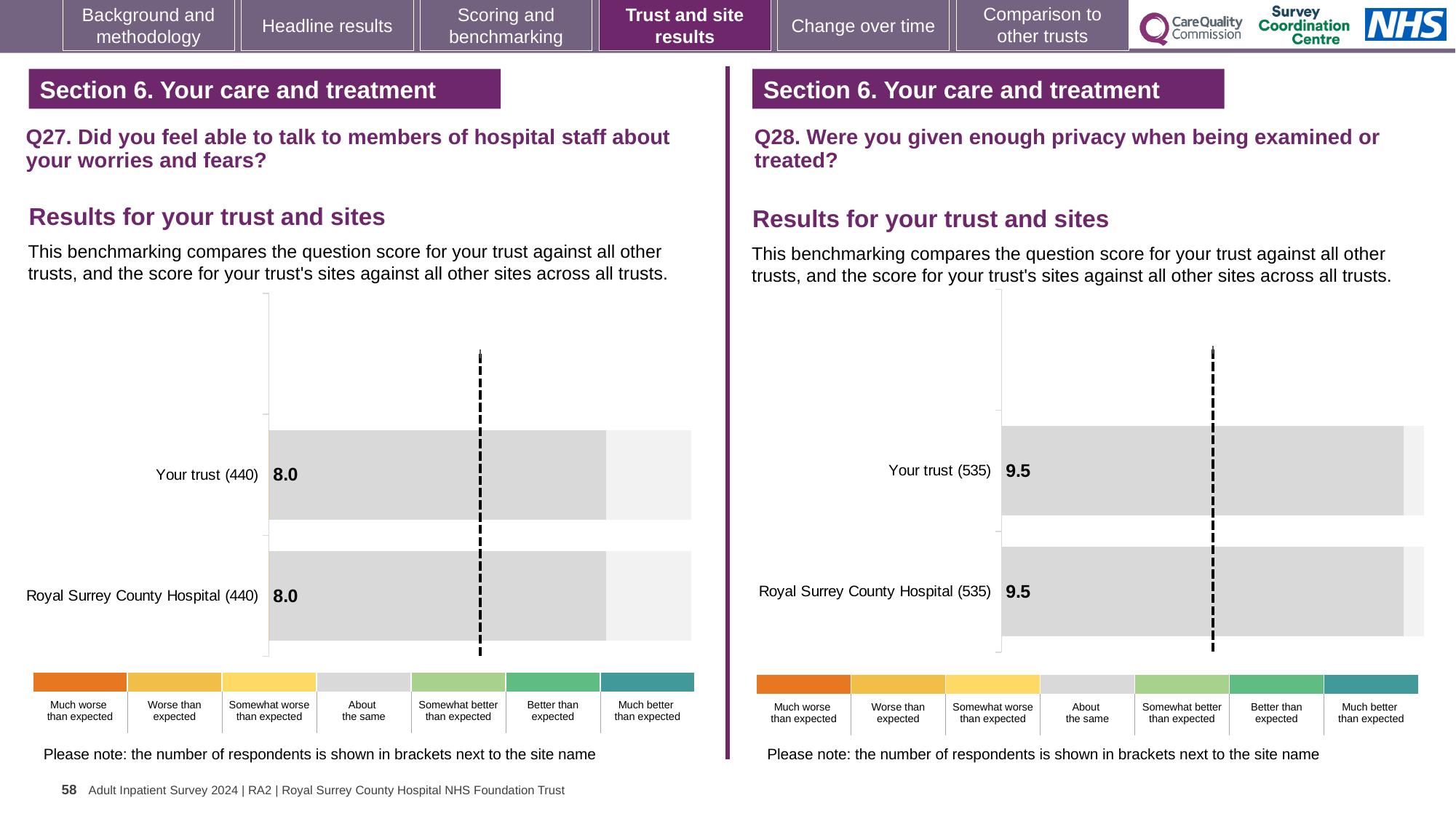
How many categories does the colour legend below the Q27 chart list? 7 How many respondents are shown in brackets for Your trust in the Q28 chart? 535 In the Q27 chart, what is the score for Your trust (440)? 8.0 What kind of chart is used for the Q27 results? Bar chart How many bars are plotted in the Q27 chart? 2 In the Q28 chart, what is the score for Royal Surrey County Hospital (535)? 9.5 Which legend category is shown in dark orange below the Q28 chart? Much worse than expected In the Q27 chart, what is the score for Royal Surrey County Hospital (440)? 8.0 In the Q28 chart, what is the difference between the score for Your trust and the score for Royal Surrey County Hospital? 0.0 In the Q28 chart, what is the score for Your trust (535)? 9.5 In the Q27 chart, what is the difference between the score for Your trust and the score for Royal Surrey County Hospital? 0.0 How many bars are plotted in the Q28 chart? 2